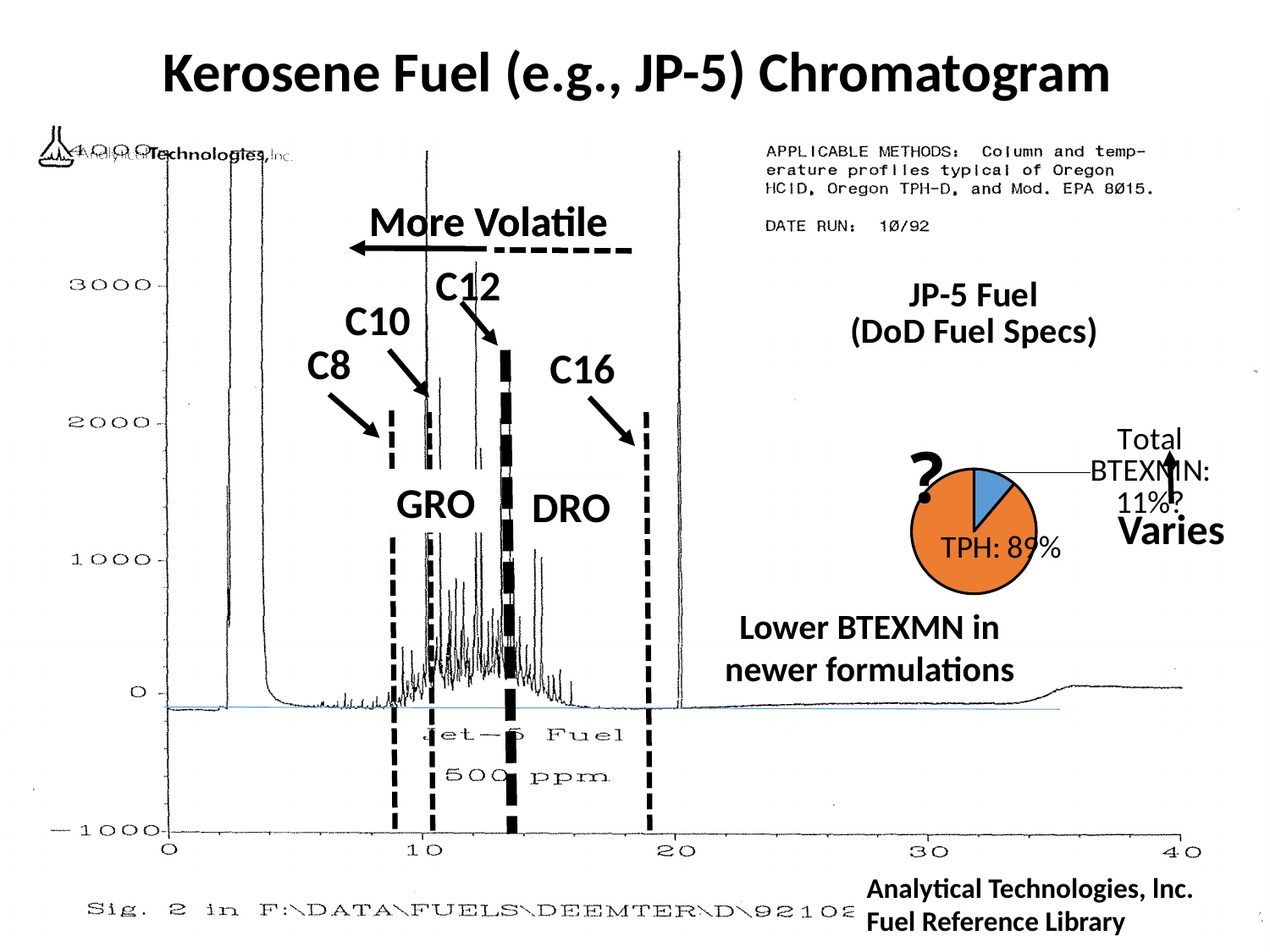
In the pie chart for JP-5 Fuel (DoD Fuel Specs), which is larger, the TPH slice or the Total BTEXMN slice? TPH In the pie chart for JP-5 Fuel (DoD Fuel Specs), by how many percentage points does the TPH share exceed the Total BTEXMN share? 78 percentage points In the pie chart for JP-5 Fuel (DoD Fuel Specs), what share is labelled for Total BTEXMN? 11% What kind of chart is the small chart on the right side of the slide labelled TPH and Total BTEXMN? Pie chart In the pie chart for JP-5 Fuel (DoD Fuel Specs), which slice is the smallest? Total BTEXMN In the pie chart for JP-5 Fuel (DoD Fuel Specs), which slice is the largest? TPH In the pie chart for JP-5 Fuel (DoD Fuel Specs), what share is labelled for TPH? 89% What kind of chart is the large chromatogram on the left of the slide? Line chart On the chromatogram on the left of the slide, what is the highest value shown on the x axis? 40 How many slices does the pie chart for JP-5 Fuel (DoD Fuel Specs) have? 2 In the pie chart for JP-5 Fuel (DoD Fuel Specs), what colour is the TPH slice? Orange In the pie chart for JP-5 Fuel (DoD Fuel Specs), what do the TPH and Total BTEXMN shares add up to? 100%